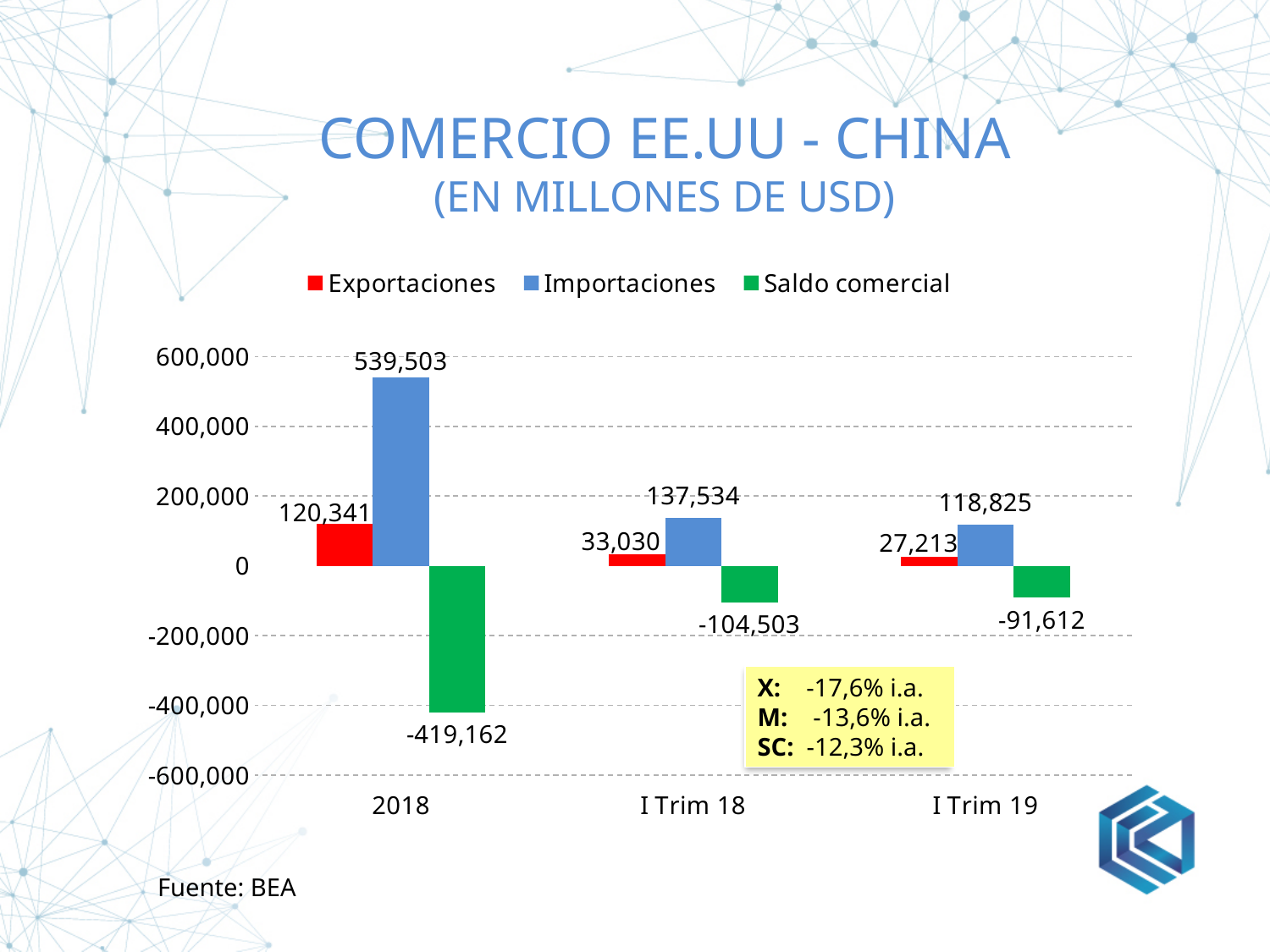
What is the value of Importaciones for I Trim 19? 118,825 What kind of chart is shown on the slide? Bar chart What is the value of Importaciones for 2018? 539,503 Which category has the highest Importaciones value? 2018 How many categories are shown on the x axis? 3 What is the value of Saldo comercial for I Trim 18? -104,503 What is the difference between Importaciones for I Trim 18 and I Trim 19? 18,709 What is the value of Exportaciones for I Trim 19? 27,213 How many series does the legend list? 3 Which category has the lowest Exportaciones value? I Trim 19 Which is larger, Exportaciones for I Trim 18 or Exportaciones for I Trim 19? I Trim 18 What colour represents Saldo comercial in the chart? Green